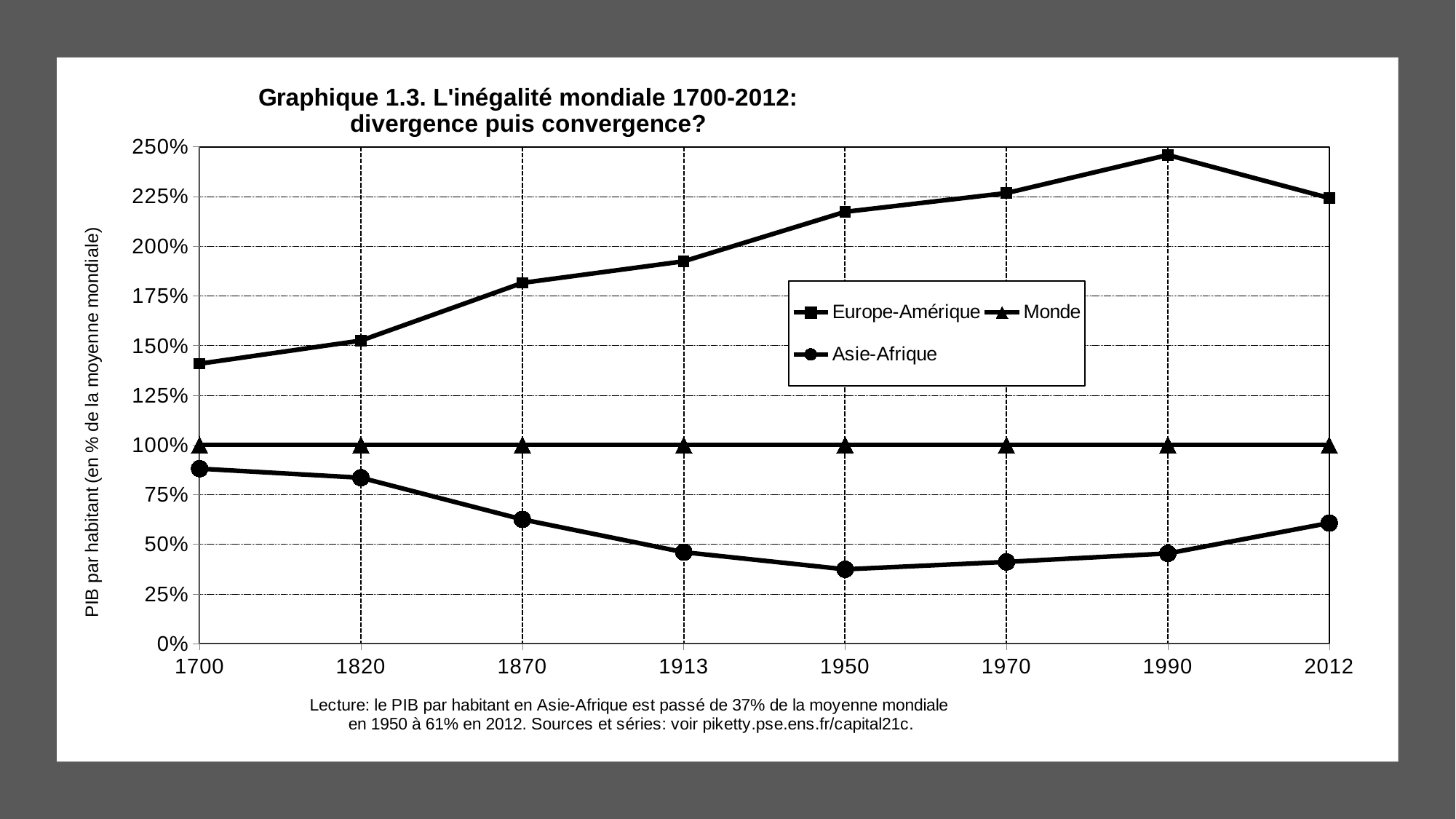
How many years are marked on the x axis? 8 What kind of chart is shown on the slide? line chart In which year does Europe-Amérique reach its highest value? 1990 How many series does the legend list? 3 In which year is the Asie-Afrique value lowest? 1950 Does the Asie-Afrique series rise or fall between 1700 and 1950? fall What is the value for Asie-Afrique in 1950? 37% What is the value for Monde in 1913? 100% Is the value for Europe-Amérique in 1950 greater or less than 200%? greater What is the value for Asie-Afrique in 2012? 61% Is the value for Europe-Amérique in 1700 greater or less than 150%? less By how many percentage points did the Asie-Afrique value rise between 1950 and 2012? 24 percentage points